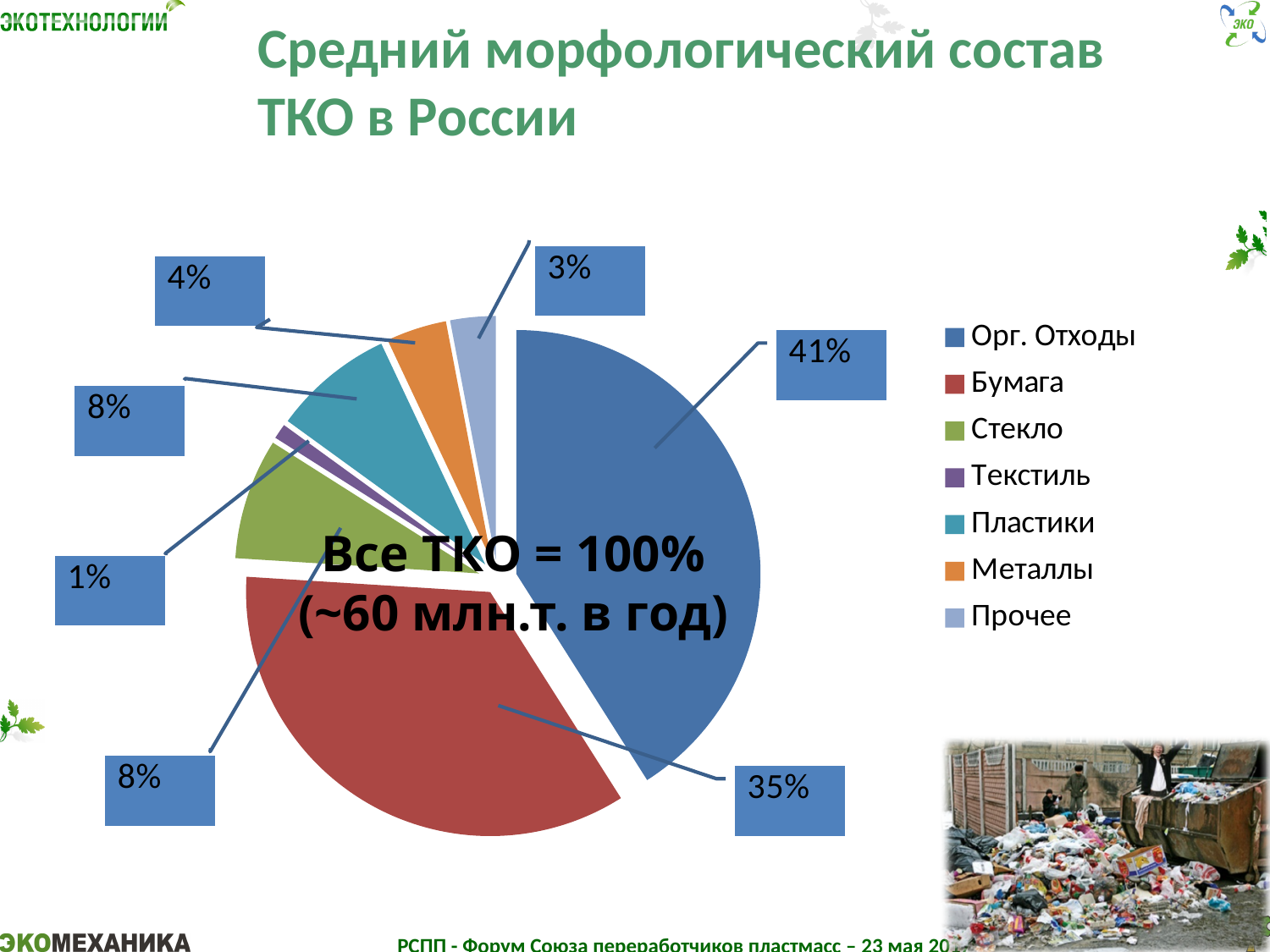
What share of the pie does Орг. Отходы have? 41% How many categories does the legend list? 7 What is the difference between the shares of Орг. Отходы and Бумага? 6% Which category has the largest slice of the pie? Орг. Отходы What share of the pie does Текстиль have? 1% What share of the pie does Бумага have? 35% What share of the pie does Металлы have? 4% What colour is the Стекло slice in the pie chart? green What share of the pie does Прочее have? 3% Which is larger, the share of Металлы or the share of Прочее? Металлы Which category has the smallest slice of the pie? Текстиль What kind of chart is shown on the slide? pie chart